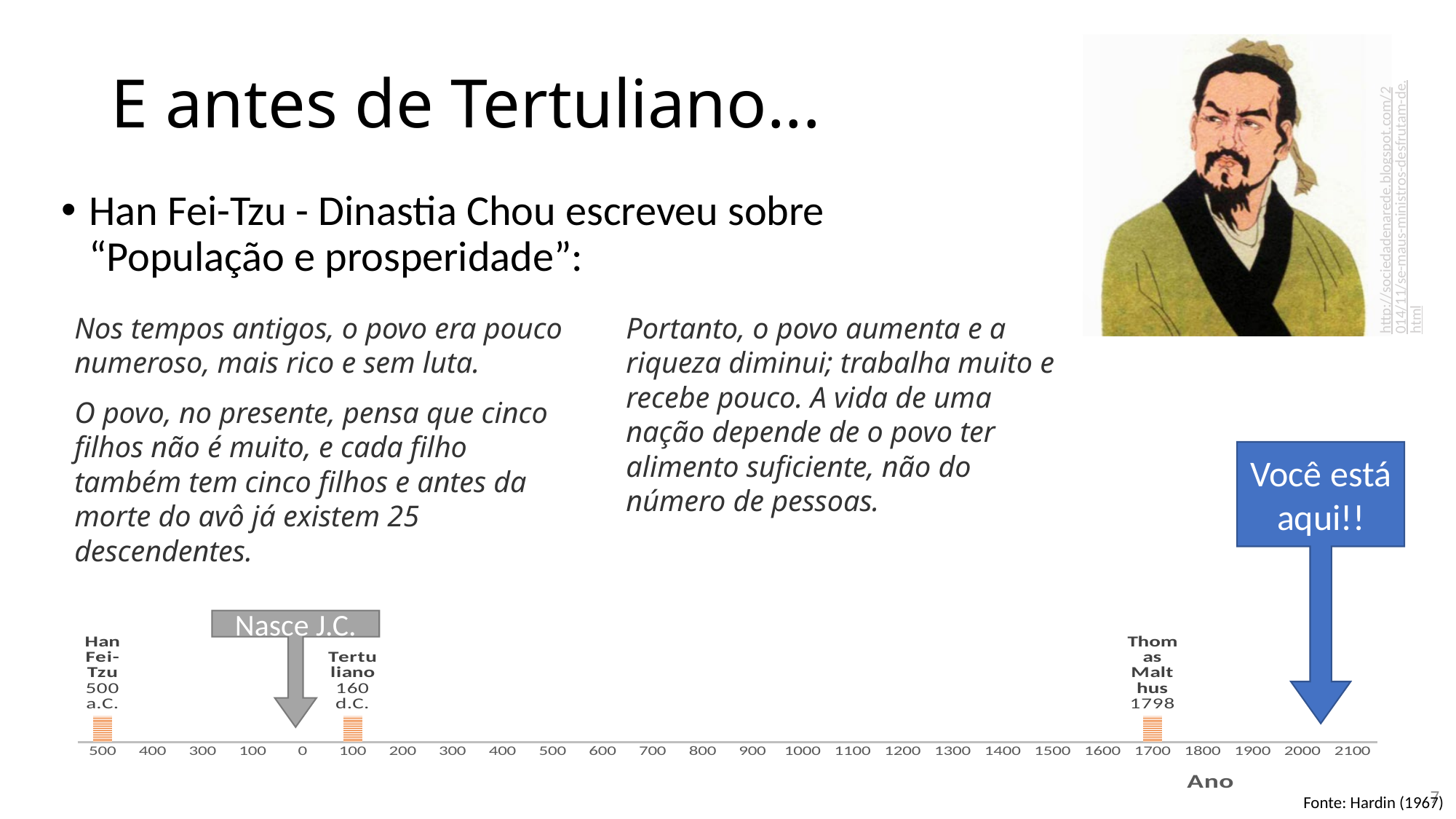
How many labelled bars (events) are plotted on the timeline chart? 3 Which event on the timeline chart is placed furthest to the right (latest)? Thomas Malthus Which event on the timeline chart is placed furthest to the left (earliest)? Han Fei-Tzu What year is printed for Thomas Malthus on the timeline chart? 1798 What is the last (rightmost) tick label on the x axis of the timeline chart? 2100 What kind of chart is the timeline at the bottom of the slide? bar chart Which is later on the timeline chart, Tertuliano or Han Fei-Tzu? Tertuliano What year is printed for Tertuliano on the timeline chart? 160 d.C. What is the title of the x axis of the timeline chart? Ano What year is printed for Han Fei-Tzu on the timeline chart? 500 a.C.